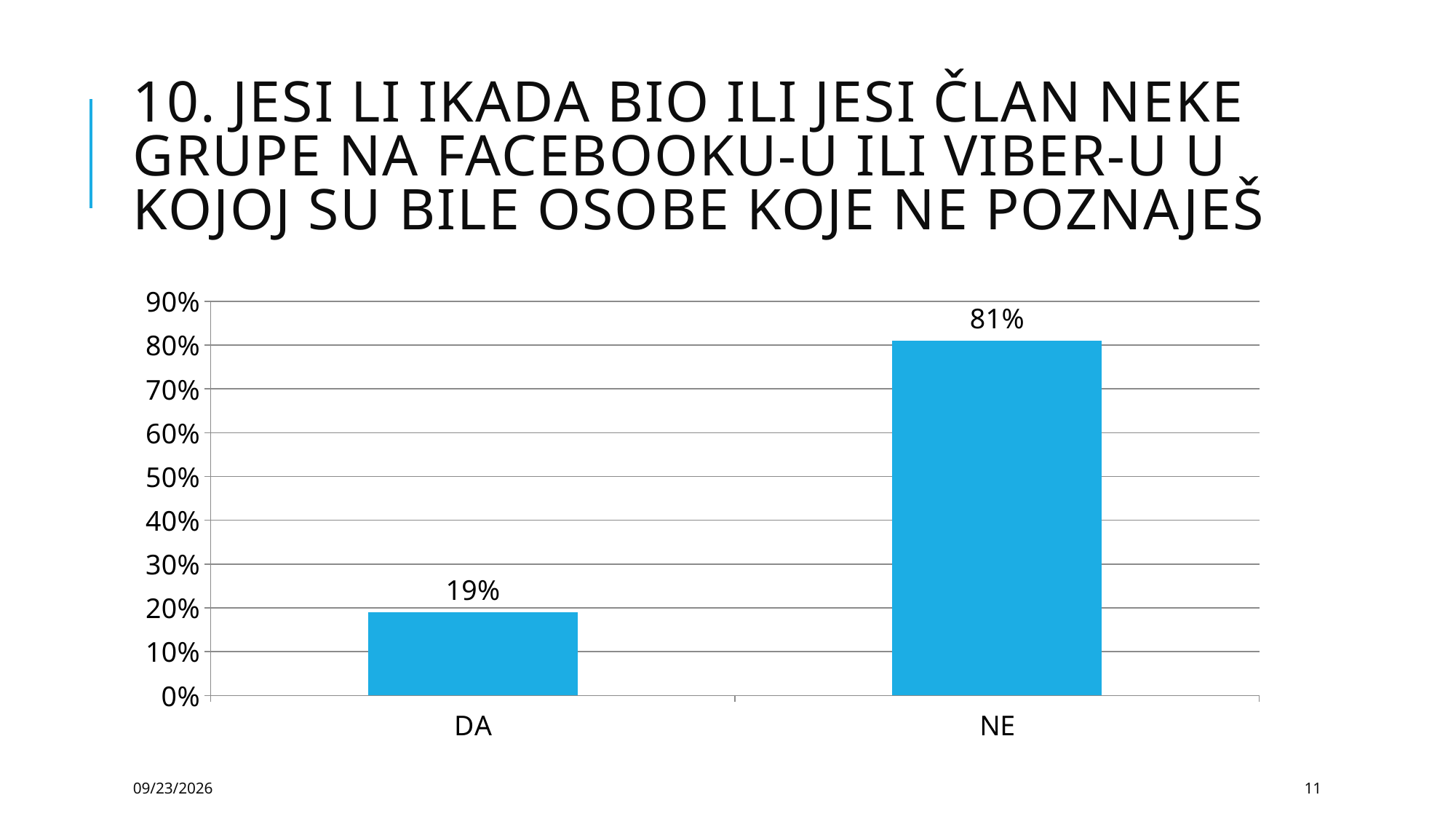
What is the highest value shown on the y axis? 90% What is the value for DA? 19% Which is larger, the value for DA or the value for NE? NE What kind of chart is shown on the slide? bar chart How many categories are shown on the x axis? 2 Which category has the highest value? NE Is the value for NE greater or less than 80%? greater What is the difference between the values for NE and DA? 62% Is the value for DA greater or less than 20%? less What is the value for NE? 81% What is the total of the values for DA and NE? 100% Which category has the lowest value? DA